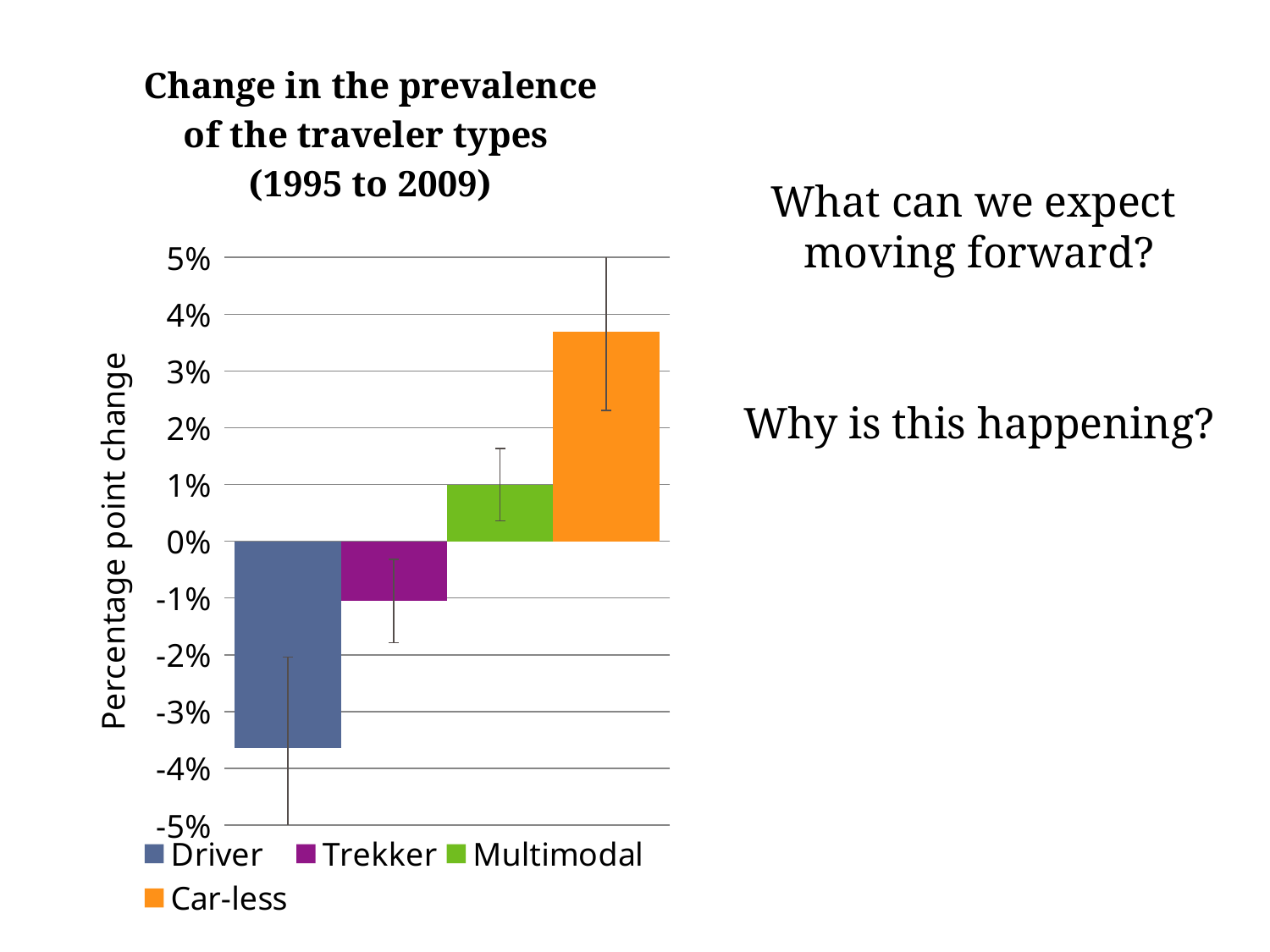
What is the label on the vertical axis of the chart? Percentage point change Is the value for Car-less greater or less than 3%? greater Which is larger, the value for Car-less or the value for Multimodal? Car-less Is the value for Driver greater or less than -3%? less What is the percentage point change for Trekker? -1% How many bars are plotted in the chart? 4 How many series does the legend list? 4 Do the bar values rise or fall moving from left to right across the chart? rise Which traveler type has the lowest percentage point change? Driver Which traveler type has the highest percentage point change? Car-less What kind of chart is shown on the slide? bar chart What is the percentage point change for Multimodal? 1%